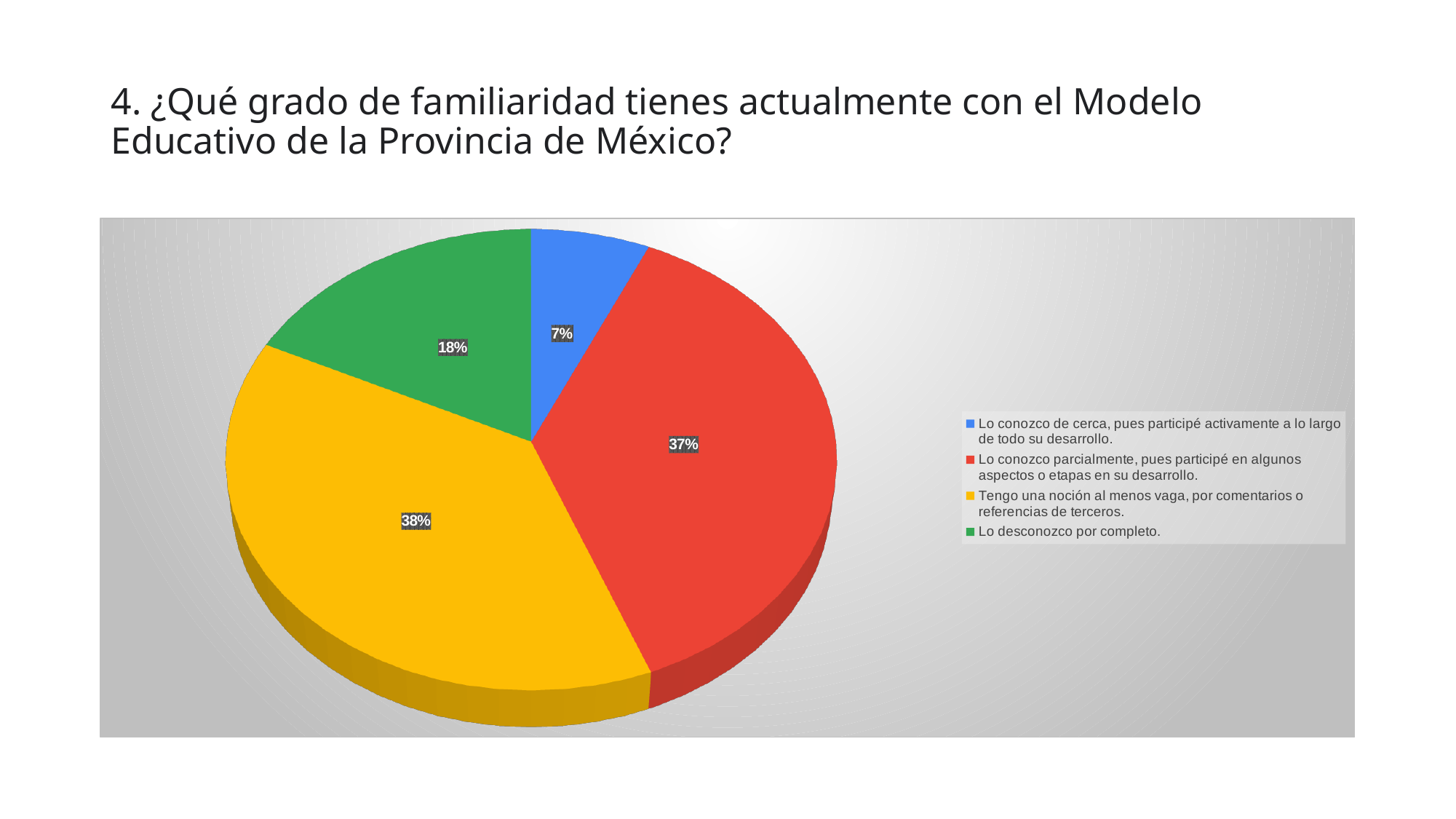
What percentage of respondents answered "Lo desconozco por completo."? 18% What kind of chart is shown on the slide? Pie chart What is the difference in percentage points between "Lo desconozco por completo." and "Lo conozco de cerca, pues participé activamente a lo largo de todo su desarrollo."? 11 percentage points What percentage of respondents answered "Tengo una noción al menos vaga, por comentarios o referencias de terceros."? 38% What percentage of respondents answered "Lo conozco parcialmente, pues participé en algunos aspectos o etapas en su desarrollo."? 37% Which is larger: the share for "Lo desconozco por completo." or the share for "Lo conozco de cerca, pues participé activamente a lo largo de todo su desarrollo."? Lo desconozco por completo. Which response has the smallest share of the pie? Lo conozco de cerca, pues participé activamente a lo largo de todo su desarrollo. What percentage of respondents answered "Lo conozco de cerca, pues participé activamente a lo largo de todo su desarrollo."? 7% What colour is the slice for "Lo desconozco por completo."? Green Which response has the largest share of the pie? Tengo una noción al menos vaga, por comentarios o referencias de terceros. How many slices does the pie chart have? 4 What is the title of the chart on the slide? 4. ¿Qué grado de familiaridad tienes actualmente con el Modelo Educativo de la Provincia de México?